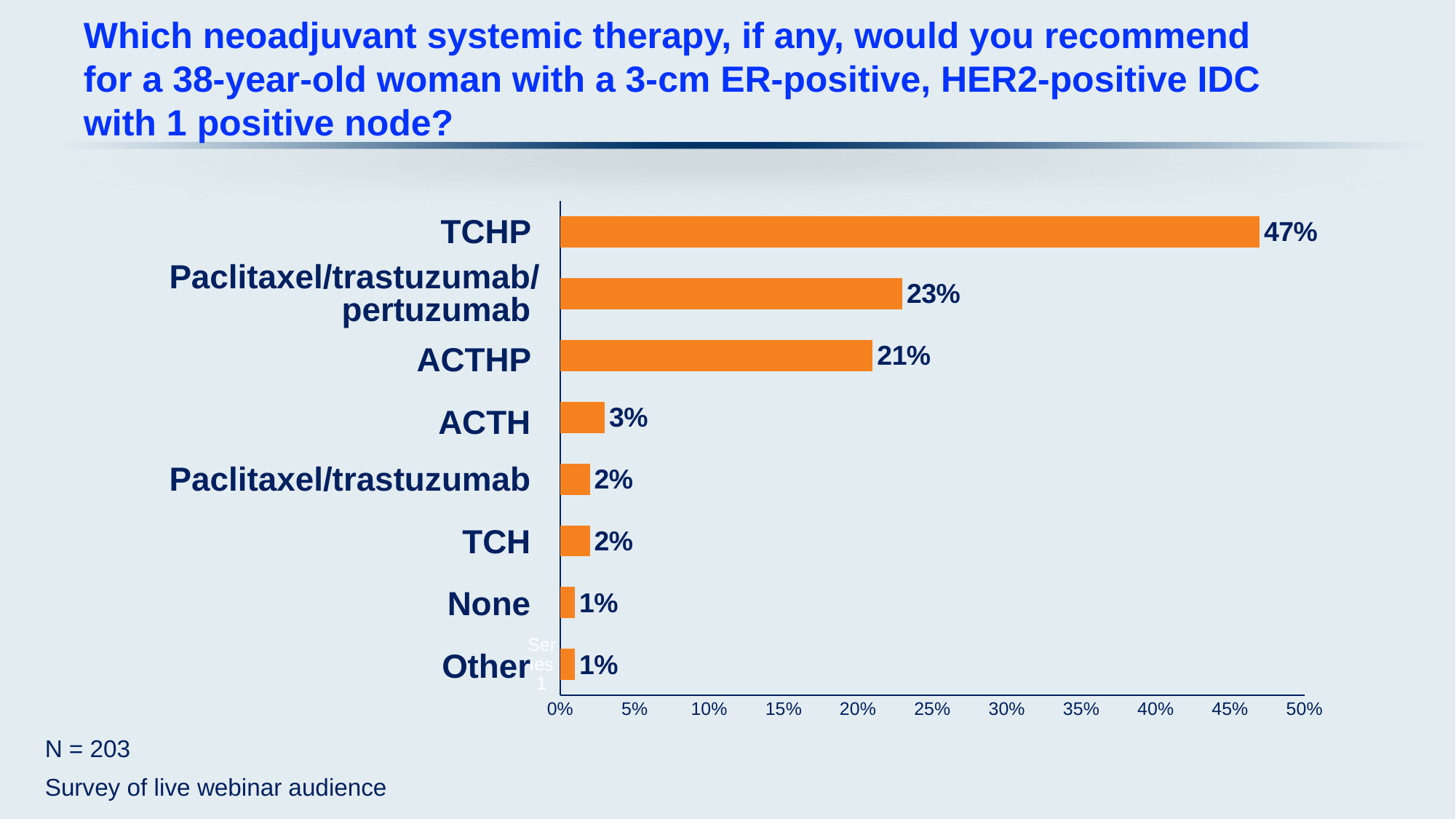
What is the difference in percentage points between ACTHP and ACTH? 18 What percentage of respondents recommended TCHP? 47% What percentage of respondents recommended Paclitaxel/trastuzumab/pertuzumab? 23% What is the survey sample size (N) stated on the slide? 203 Which received a larger share of responses, Paclitaxel/trastuzumab/pertuzumab or ACTHP? Paclitaxel/trastuzumab/pertuzumab Is the value for TCHP greater or less than 45%? greater Which therapy option received the highest percentage of responses? TCHP How many therapy options are shown on the chart? 8 What percentage of respondents recommended ACTHP? 21% What kind of chart is shown on the slide? Bar chart What percentage of respondents recommended ACTH? 3% What is the difference in percentage points between TCHP and Paclitaxel/trastuzumab/pertuzumab? 24